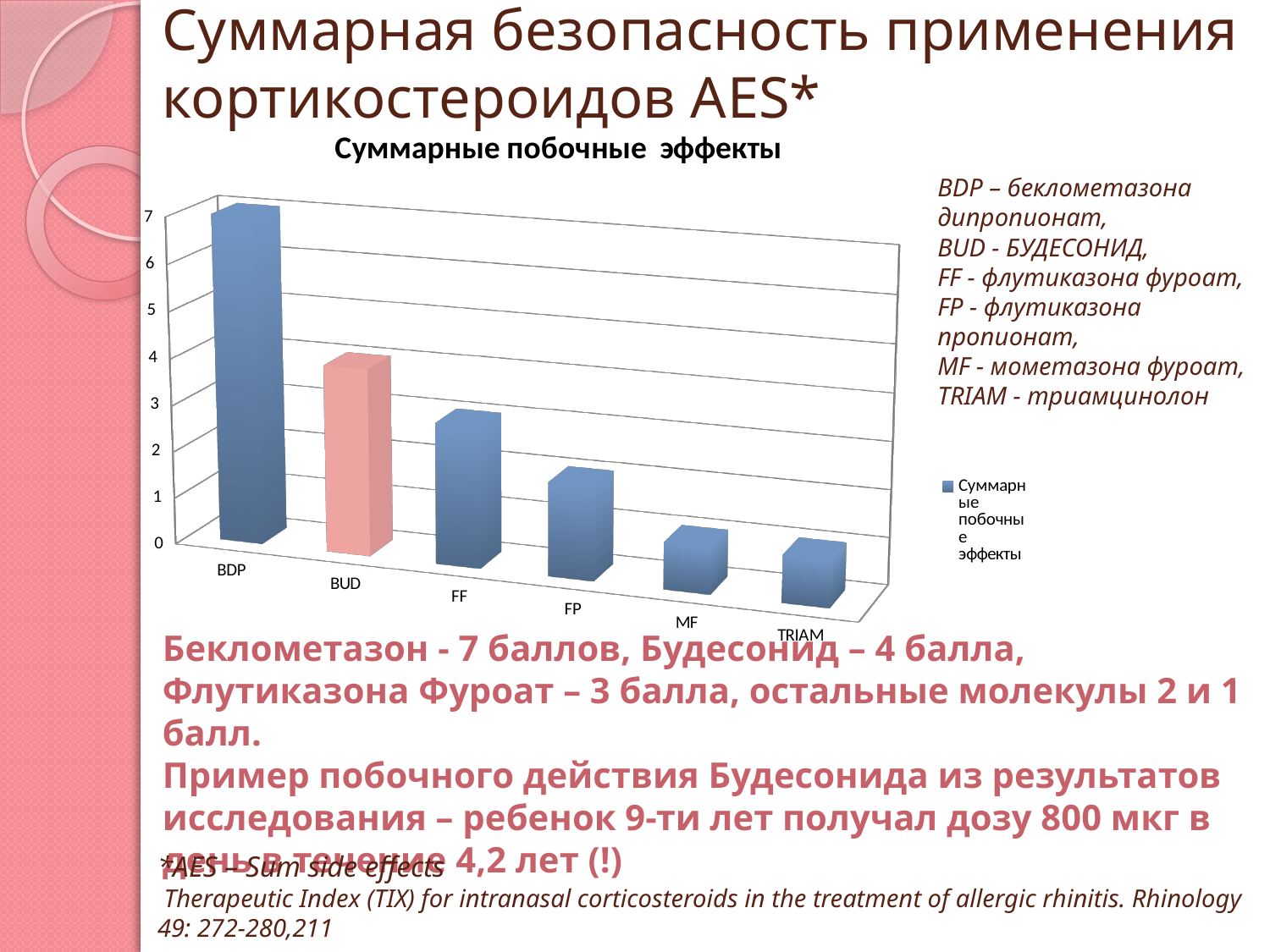
What is the value for FF in the chart? 3 What is the value for BUD in the chart? 4 What is the title of the chart? Суммарные побочные эффекты What kind of chart is shown on the slide? bar chart Which category has the highest value in the chart? BDP How many series does the chart legend list? 1 What is the value for BDP in the chart? 7 What is the difference between the values for BDP and BUD? 3 How many categories are plotted on the x axis of the chart? 6 Is the value for MF greater or less than 2? less Which is larger, the value for FF or the value for FP? FF Do the values rise or fall moving from BDP to TRIAM along the x axis? fall